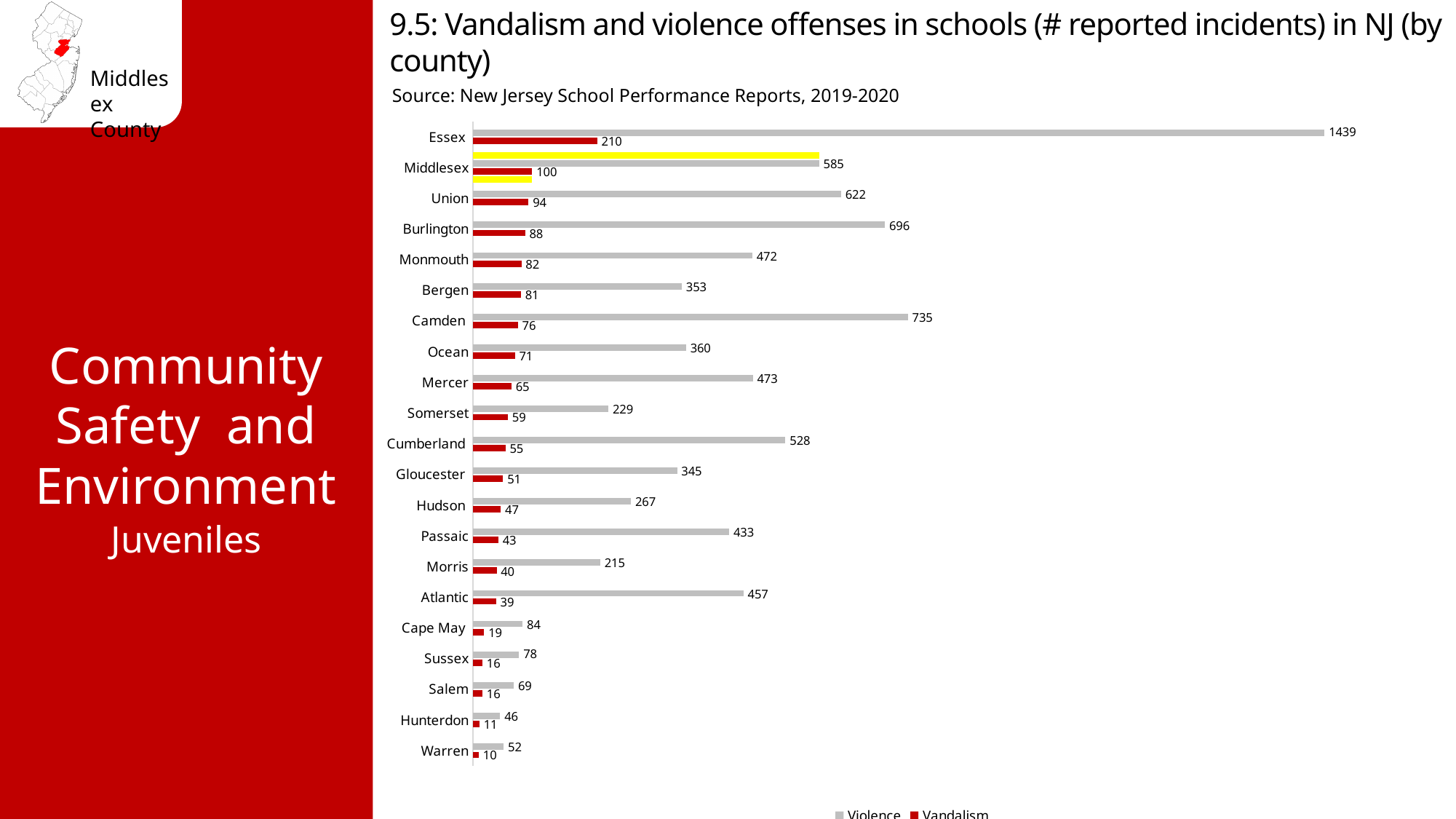
What is the number of reported violence incidents in Essex County? 1439 What is the difference between the violence incidents in Camden and Burlington? 39 How many counties are shown on the chart? 21 What kind of chart is shown on the slide? Bar chart Which series is shown in red on the chart? Vandalism Which county has the highest number of reported violence incidents? Essex What is the number of reported vandalism incidents in Middlesex County? 100 How many series does the legend list? 2 Which county has the lowest number of reported vandalism incidents? Warren Which county has more reported violence incidents, Union or Middlesex? Union What is the difference between vandalism incidents in Essex and Middlesex? 110 What is the number of reported violence incidents in Hunterdon County? 46